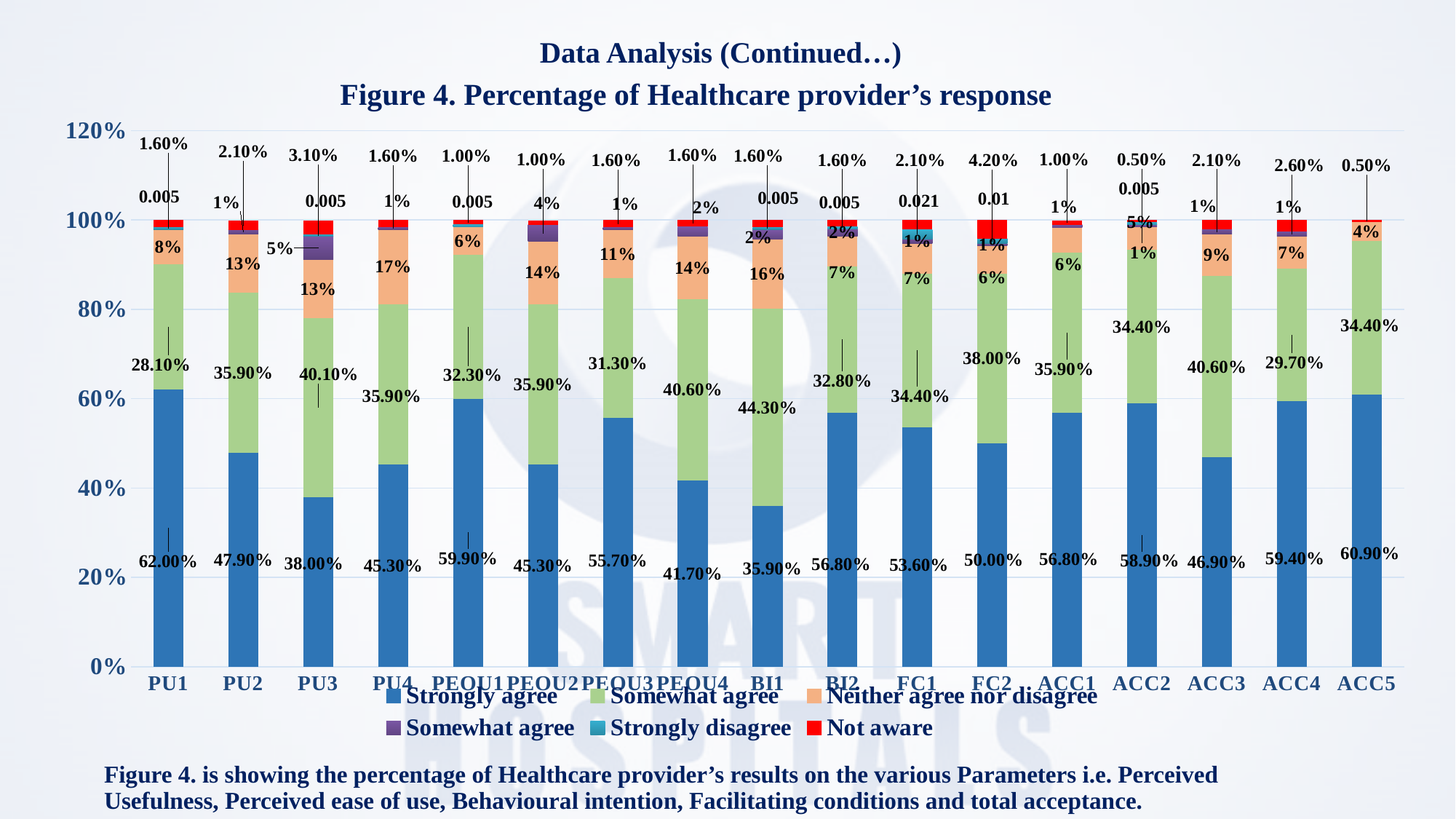
What is the Somewhat agree (green) value for BI1? 44.30% What is the difference between the Strongly agree values for PU1 and BI1? 26.10 percentage points What is the Strongly agree value for PU1? 62.00% Which category has the highest Not aware value? FC2 How many series does the legend list? 6 Which category has the lowest Strongly agree value? BI1 Which has a larger Strongly agree value, PEOU1 or PEOU4? PEOU1 Which category has the highest Strongly agree value? PU1 What is the Not aware value for FC2? 4.20% What is the Neither agree nor disagree value for PU4? 17% How many categories are shown on the x axis? 17 What kind of chart is shown? Stacked bar chart